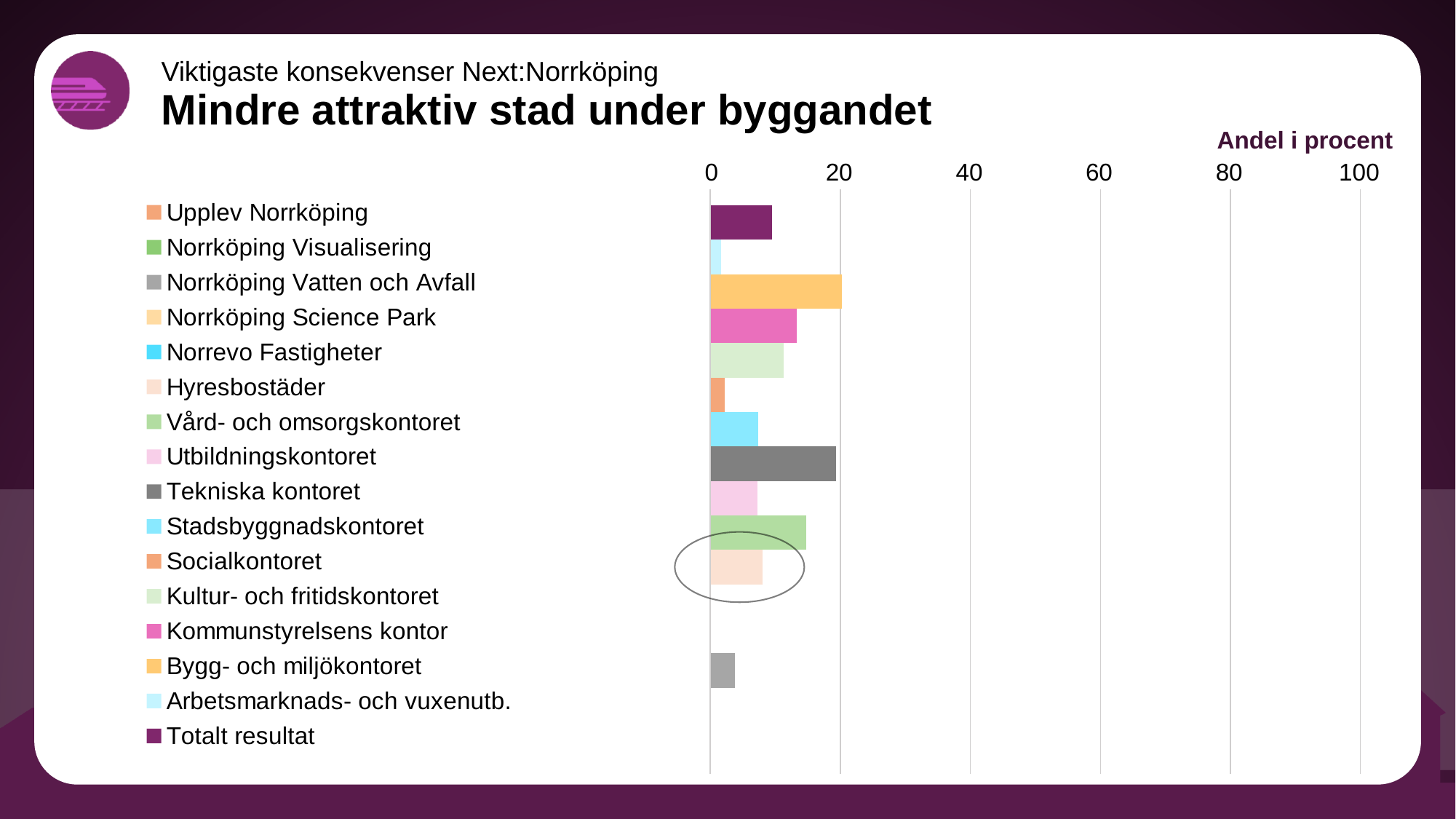
What is the title of the chart's value axis? Andel i procent Which is larger, the value for Vård- och omsorgskontoret or the value for Hyresbostäder? Vård- och omsorgskontoret Which is larger, the value for Bygg- och miljökontoret or the value for Socialkontoret? Bygg- och miljökontoret What is the highest tick value shown on the horizontal axis? 100 Which is larger, the value for Tekniska kontoret or the value for Utbildningskontoret? Tekniska kontoret Is the value for Vård- och omsorgskontoret greater or less than 20? less Is the value for Bygg- och miljökontoret greater or less than 40? less How many entries does the legend list? 16 What kind of chart is shown on the slide? bar chart Is the value for Totalt resultat greater or less than 20? less